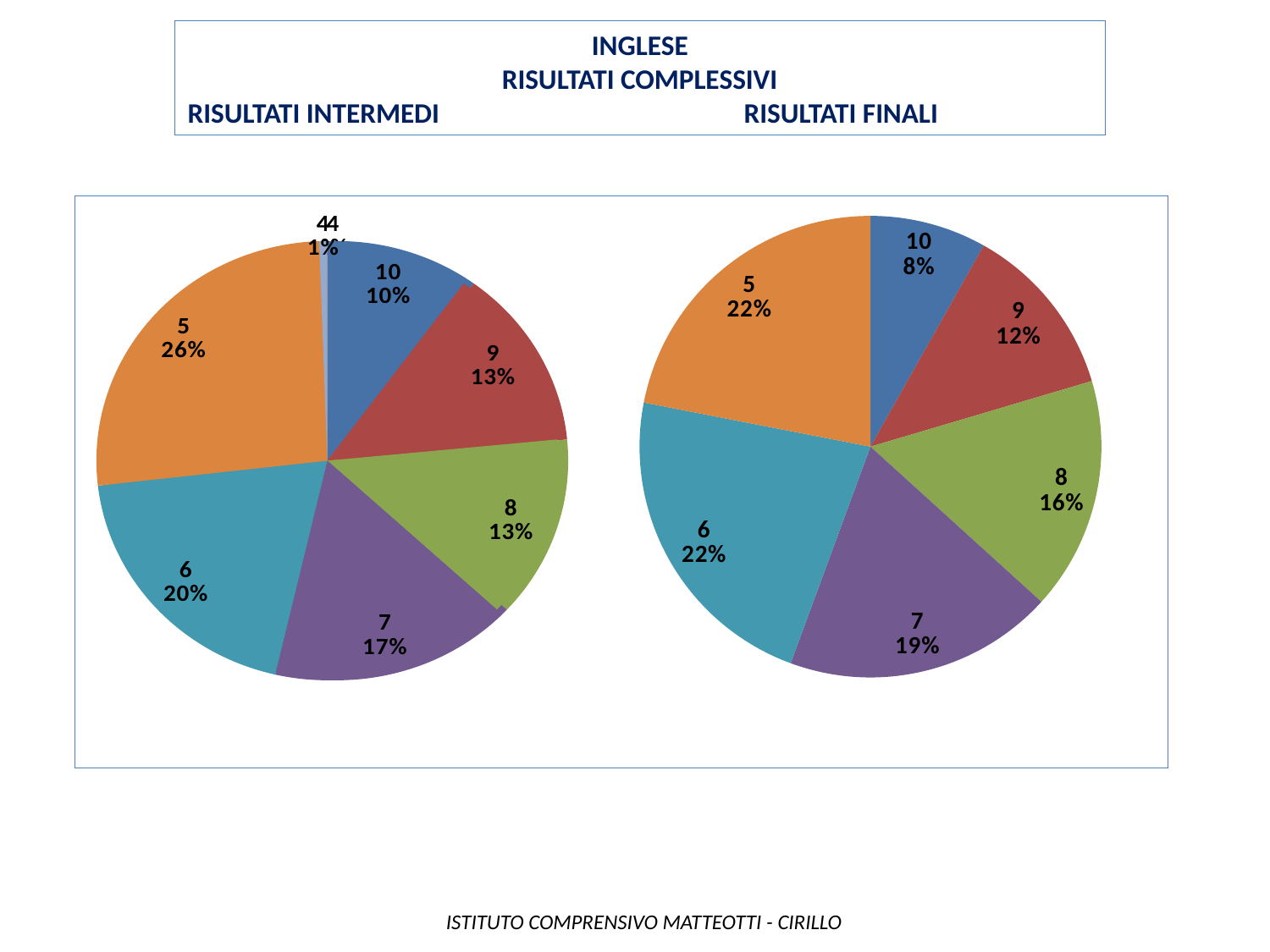
In the RISULTATI FINALI pie chart, what share does grade 10 have? 8% In the RISULTATI FINALI pie chart, which is larger, the share of grade 8 or the share of grade 9? grade 8 In the RISULTATI INTERMEDI pie chart, which grade has the largest share? 5 In the RISULTATI INTERMEDI pie chart, what is the difference between the shares of grade 6 and grade 7? 3% What subject do the charts on this slide refer to, according to the title? INGLESE In the RISULTATI INTERMEDI pie chart, which is larger, the share of grade 6 or the share of grade 10? grade 6 In the RISULTATI FINALI pie chart, what is the difference between the shares of grade 7 and grade 9? 7% In the RISULTATI INTERMEDI pie chart, what share does grade 5 have? 26% What type of chart is used for RISULTATI INTERMEDI? pie chart In the RISULTATI FINALI pie chart, which grade has the smallest share? 10 In the RISULTATI FINALI pie chart, what share does grade 8 have? 16% How many slices does the RISULTATI FINALI pie chart have? 6